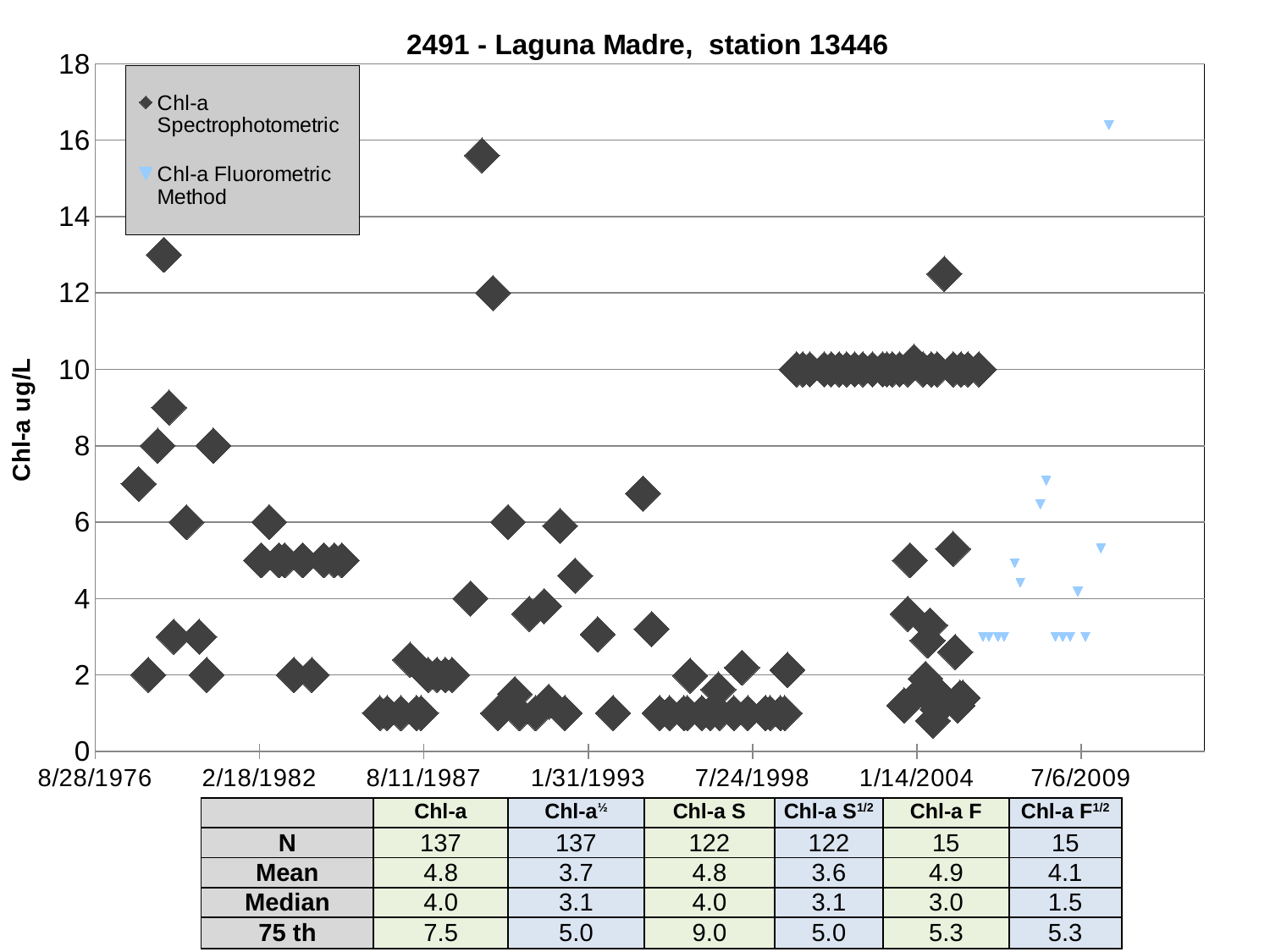
Is the highest Chl-a Fluorometric Method value on the chart greater or less than 16? greater Is the earliest Chl-a Spectrophotometric point (near 1976) greater or less than 6? greater What is the title of the chart? 2491 - Laguna Madre, station 13446 How many series does the chart legend list? 2 What is the label on the vertical axis of the chart? Chl-a ug/L Is the highest Chl-a Spectrophotometric value on the chart greater or less than 14? greater In the table below the chart, what is N for Chl-a F? 15 What kind of chart is shown on the slide? scatter chart In the table below the chart, what is the 75th percentile for Chl-a S? 9.0 Which series has the single highest point on the chart, Chl-a Spectrophotometric or Chl-a Fluorometric Method? Chl-a Fluorometric Method In the table below the chart, what is the Median for Chl-a F½? 1.5 In the table below the chart, what is the Mean for Chl-a? 4.8